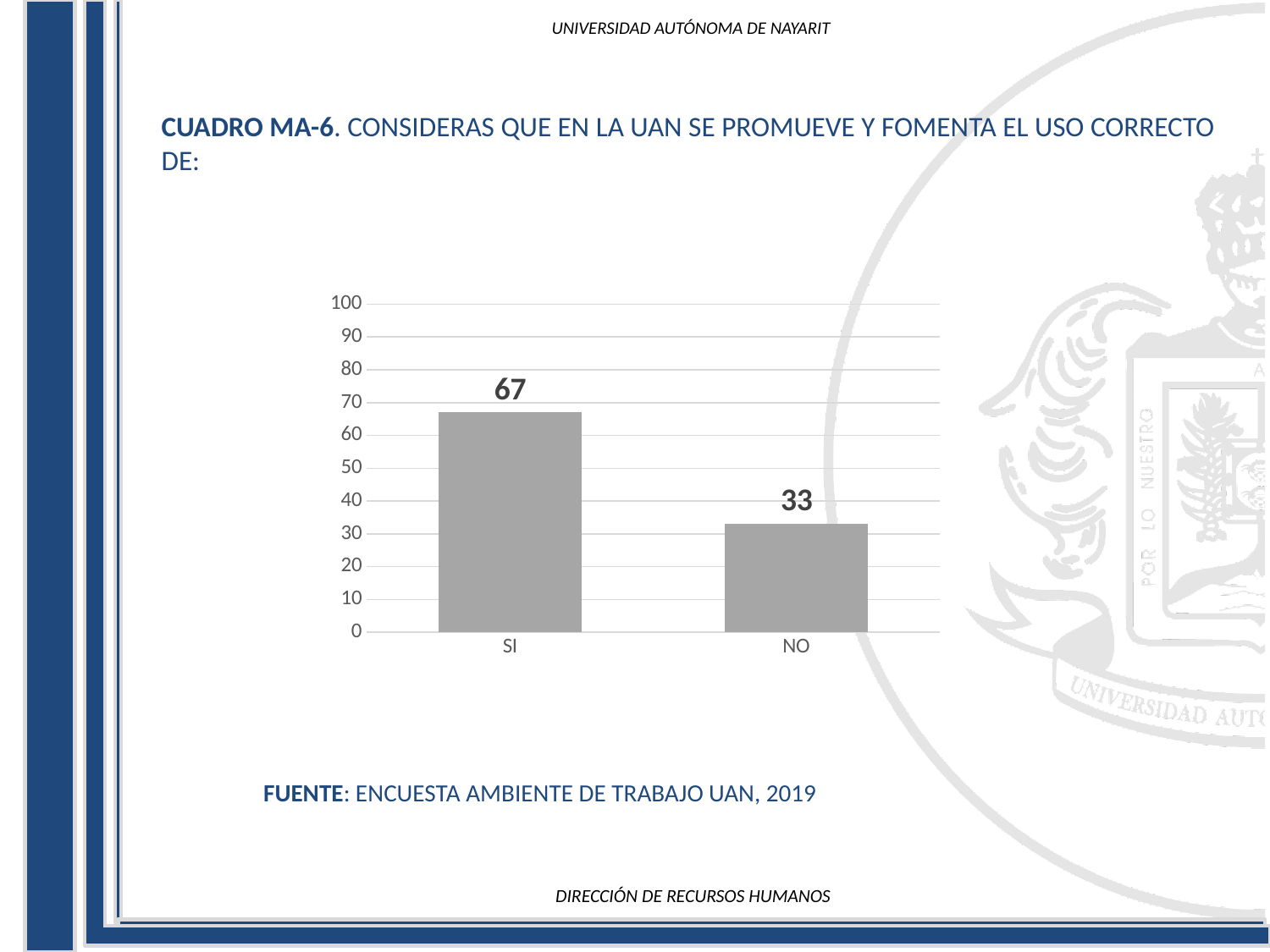
Is the value for SI greater or less than 50? greater What is the total of the values for SI and NO? 100 What is the value for SI? 67 Which is larger, the value for SI or the value for NO? SI How many categories are shown on the x axis? 2 Is the value for NO greater or less than 40? less What is the value for NO? 33 Which category has the highest value? SI What kind of chart is shown on the slide? bar chart What is the difference between the values for SI and NO? 34 What is the maximum value shown on the y axis? 100 Which category has the lowest value? NO